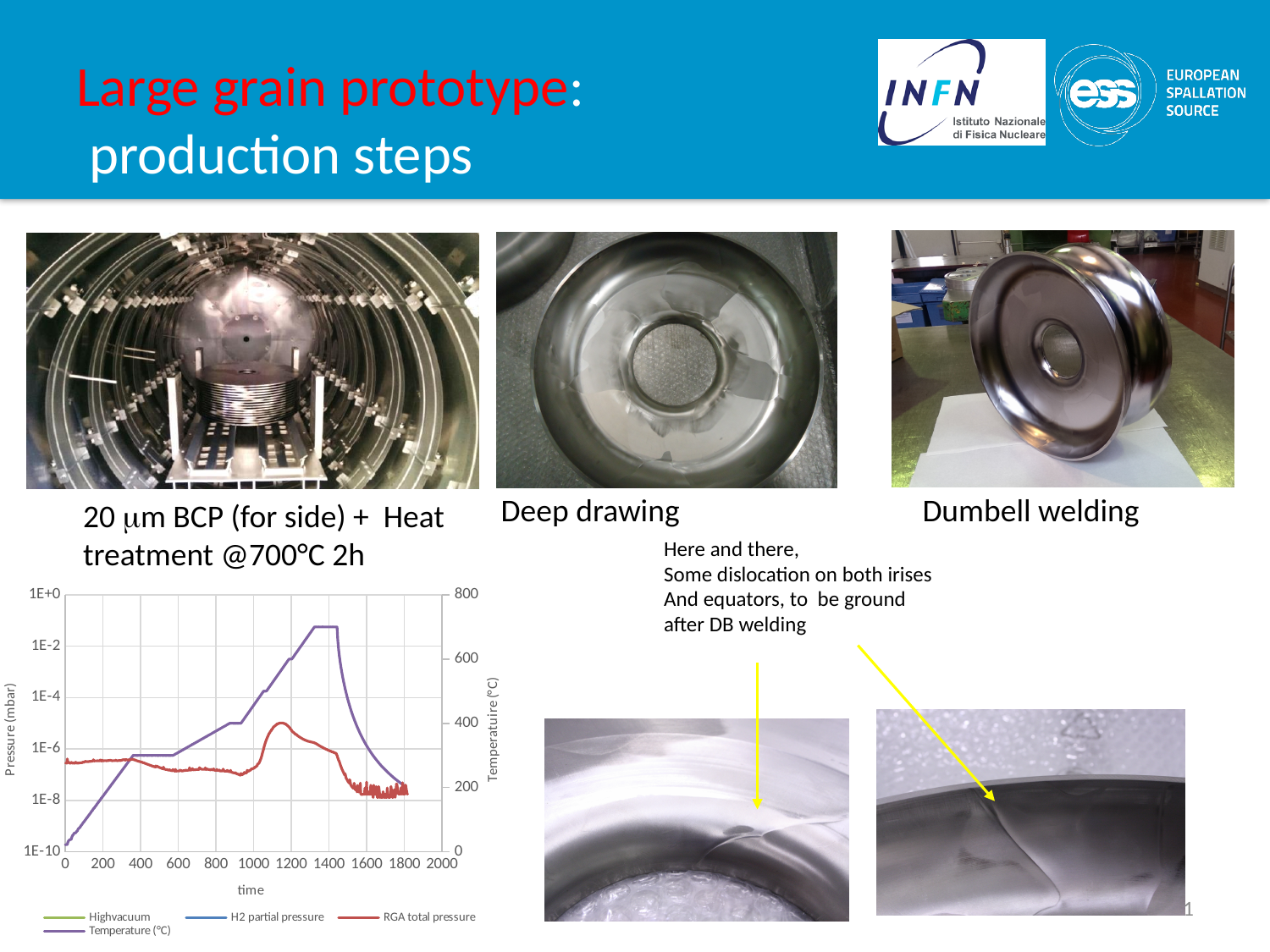
What is the label of the x axis of the chart? time Is the Temperature (°C) value at time 1600 greater or less than 400? less What kind of chart is shown on the slide? line chart Is the peak value of the RGA total pressure series greater or less than 1E-4 mbar? less Does the Temperature (°C) series rise or fall between time 1400 and time 1800? fall Is the Temperature (°C) value at time 0 greater or less than 200? less Is the RGA total pressure higher at time 1200 or at time 1800? time 1200 What is the label of the right-hand vertical axis of the chart? Temperatuire (°C) Does the Temperature (°C) series rise or fall between time 400 and time 1400? rise How many series does the chart legend list? 4